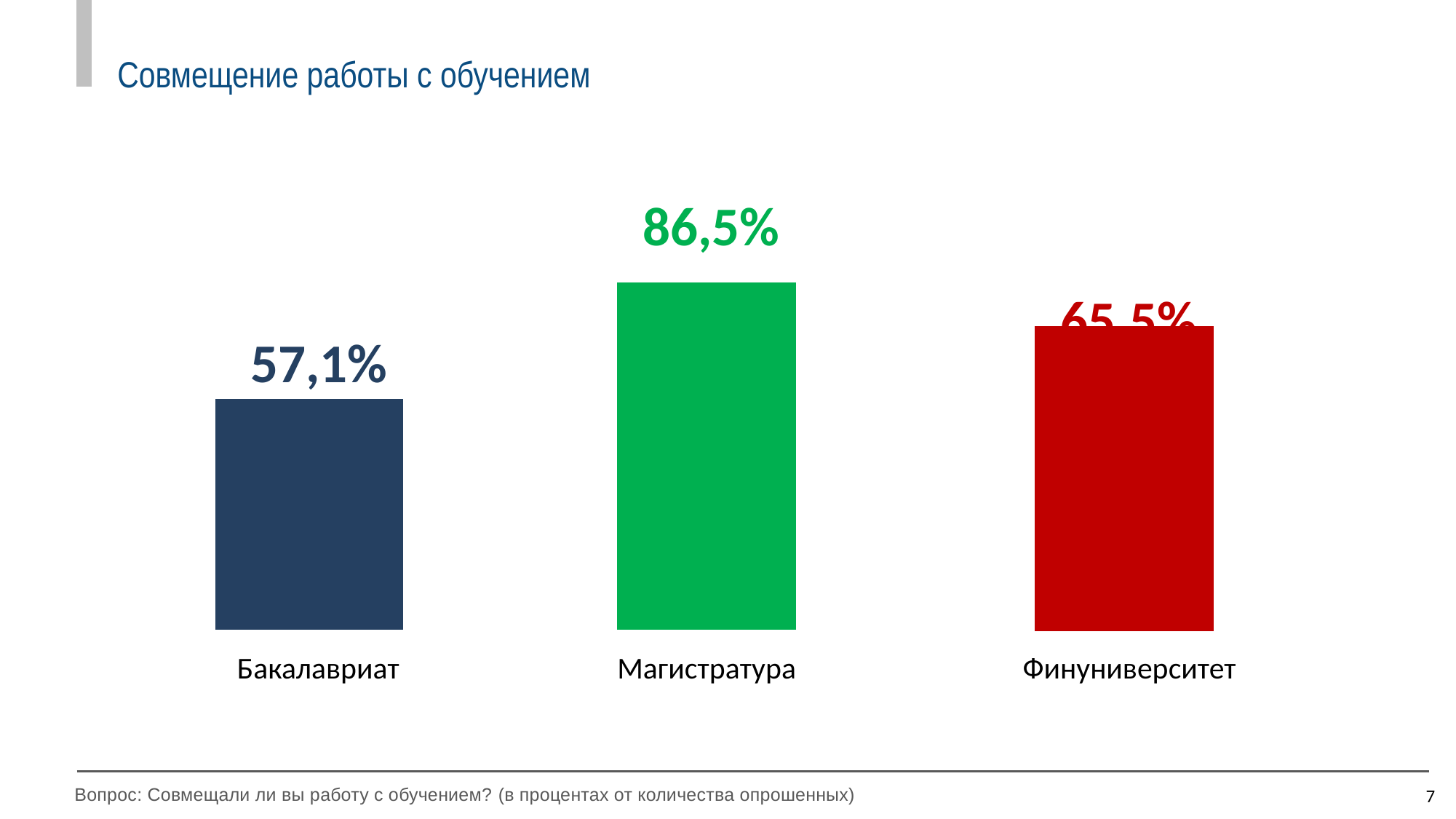
Which category has the lowest value? Бакалавриат How many categories are shown in the chart? 3 Which category has the highest value? Магистратура What is the value for Бакалавриат? 57,1% What is the value for Магистратура? 86,5% Which is larger, the value for Магистратура or the value for Финуниверситет? Магистратура Which is larger, the value for Финуниверситет or the value for Бакалавриат? Финуниверситет What is the value for Финуниверситет? 65,5% What kind of chart is shown on the slide? Bar chart What is the difference between the values for Финуниверситет and Бакалавриат? 8,4% What is the difference between the values for Магистратура and Бакалавриат? 29,4% What is the title of the slide? Совмещение работы с обучением